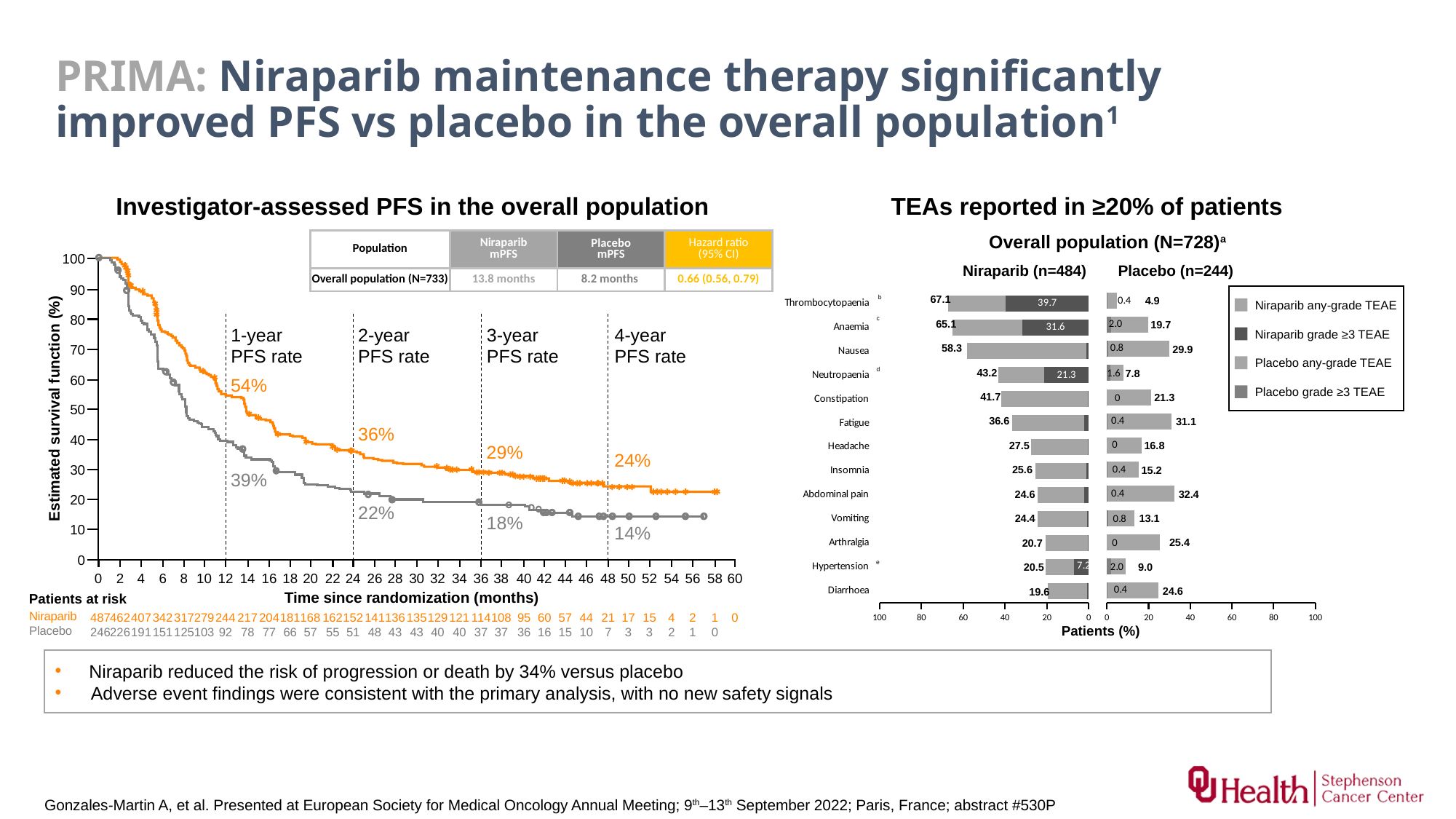
In the 'Investigator-assessed PFS in the overall population' chart, what is the 1-year PFS rate for niraparib? 54% In the 'TEAs reported in ≥20% of patients' chart, which TEAE has the highest niraparib any-grade rate? Thrombocytopaenia In the 'TEAs reported in ≥20% of patients' chart, what is the placebo any-grade TEAE rate for abdominal pain? 32.4 In the 'TEAs reported in ≥20% of patients' chart, what is the niraparib any-grade TEAE rate for nausea? 58.3 In the 'Investigator-assessed PFS in the overall population' chart, do the survival curves rise or fall as time since randomization increases? fall In the 'Investigator-assessed PFS in the overall population' chart, what is the difference between the niraparib and placebo 2-year PFS rates? 14% In the 'Investigator-assessed PFS in the overall population' chart, what is the median PFS for placebo shown in the table? 8.2 months In the 'TEAs reported in ≥20% of patients' chart, which is larger: the niraparib grade ≥3 rate for thrombocytopaenia or for anaemia? Thrombocytopaenia In the 'TEAs reported in ≥20% of patients' chart, how many entries does the legend list? 4 What kind of chart is the 'TEAs reported in ≥20% of patients' chart? Bar chart In the 'Investigator-assessed PFS in the overall population' chart, what is the 4-year PFS rate for placebo? 14% In the 'TEAs reported in ≥20% of patients' chart, how many TEAE categories are listed? 13